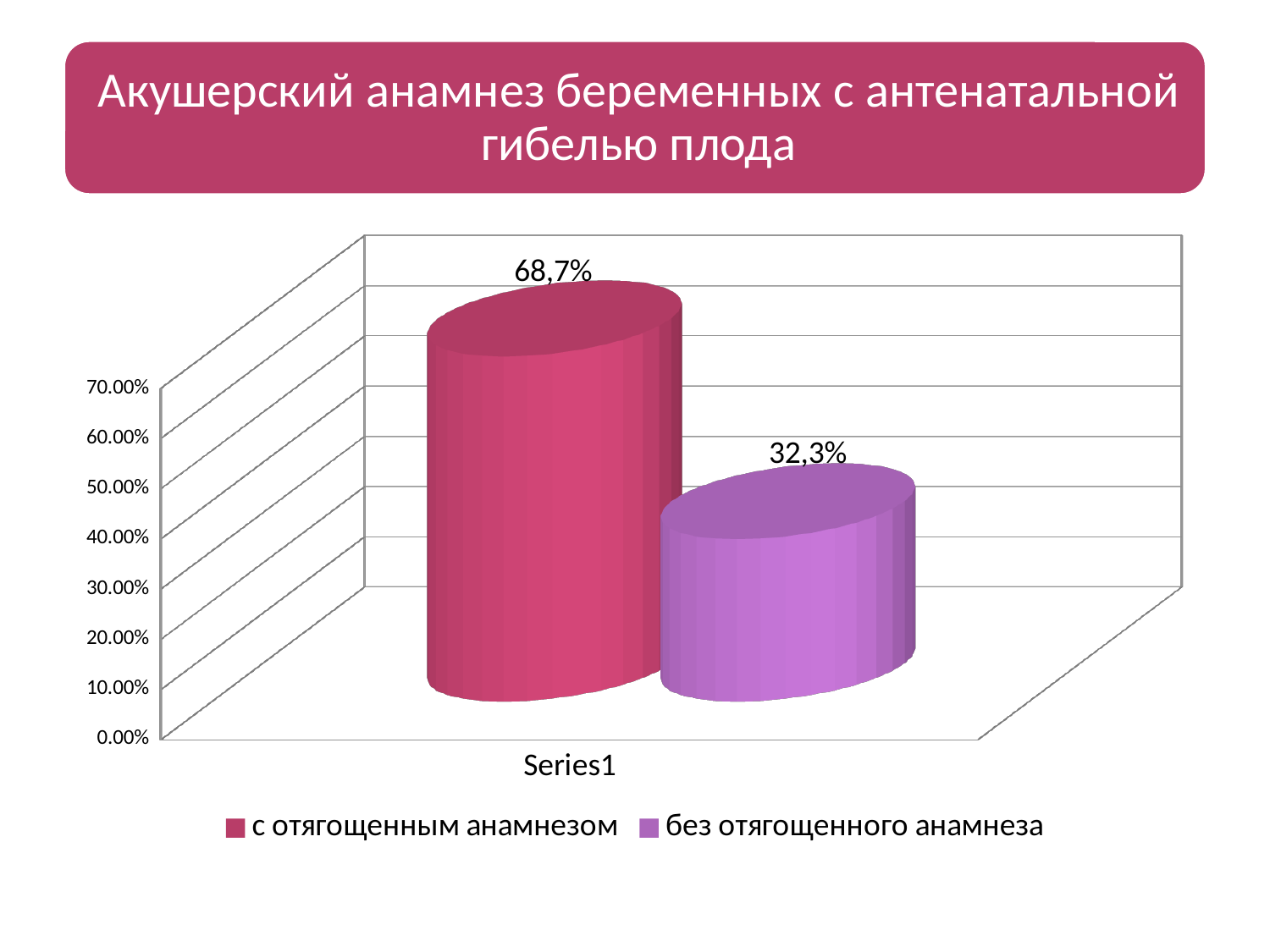
What value is shown for the series "без отягощенного анамнеза"? 32,3% Which series has the lowest value? без отягощенного анамнеза What is the title of the slide? Акушерский анамнез беременных с антенатальной гибелью плода What is the difference between the values for "с отягощенным анамнезом" and "без отягощенного анамнеза"? 36,4% Is the value for "с отягощенным анамнезом" greater or less than 60.00%? greater Which series has the highest value? с отягощенным анамнезом What value is shown for the series "с отягощенным анамнезом"? 68,7% How many series does the legend list? 2 Which is larger: the value for "с отягощенным анамнезом" or the value for "без отягощенного анамнеза"? с отягощенным анамнезом What is the label shown on the category axis of the chart? Series1 Is the value for "без отягощенного анамнеза" greater or less than 40.00%? less What kind of chart is shown on the slide? bar chart